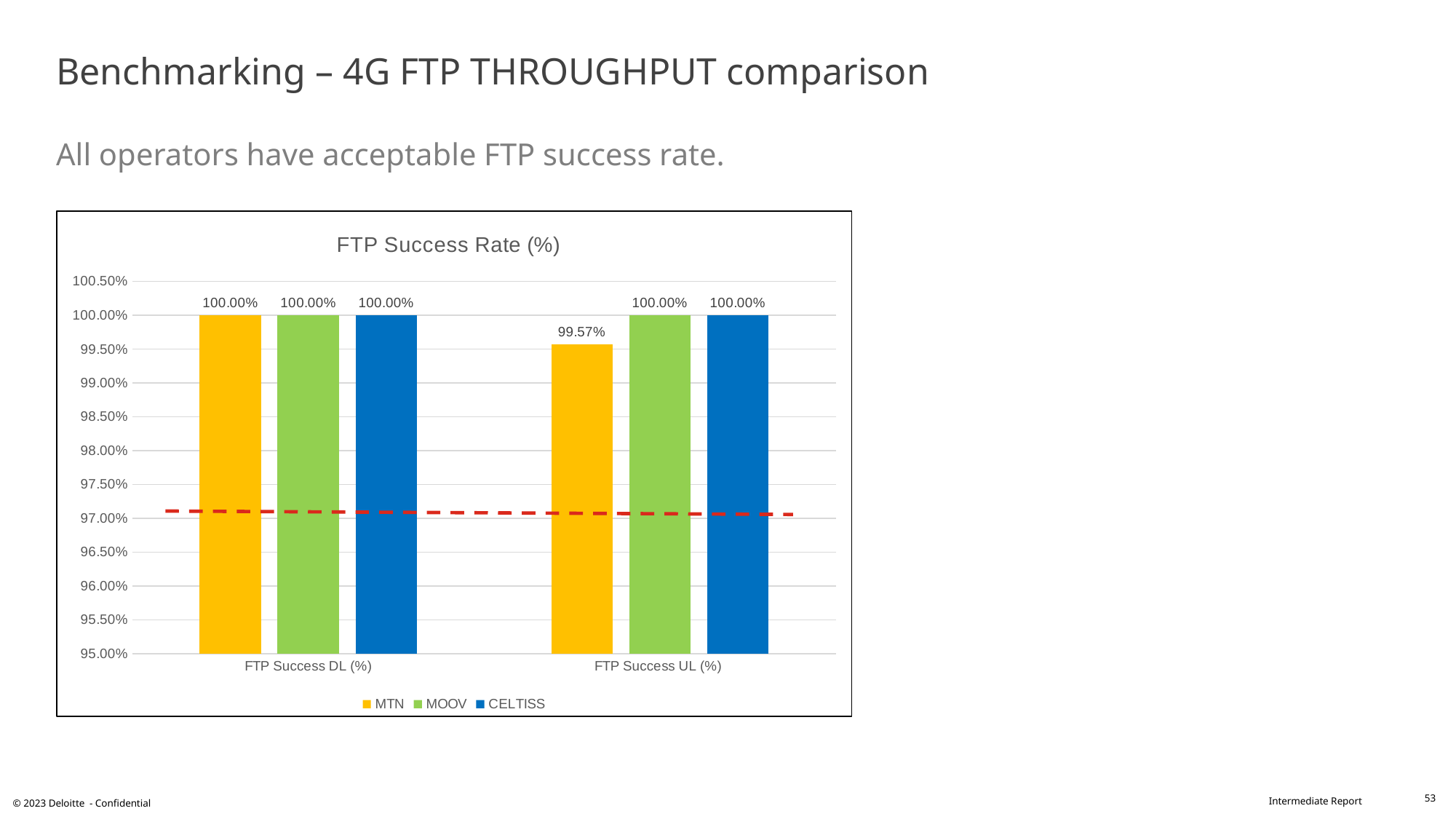
Which operator has the lowest FTP Success UL (%)? MTN What is the FTP Success DL (%) value for CELTISS? 100.00% What kind of chart is shown on the slide? Bar chart Which is larger: MTN's FTP Success DL (%) or MTN's FTP Success UL (%)? FTP Success DL (%) How many categories are shown on the x axis? 2 What is the FTP Success UL (%) value for MOOV? 100.00% Is the value for MTN in FTP Success UL (%) greater or less than 99.00%? greater Which colour represents CELTISS in the chart? Blue What is the difference between MOOV's and MTN's FTP Success UL (%) values? 0.43% How many series does the legend list? 3 What is the FTP Success UL (%) value for MTN? 99.57% What is the title of the chart? FTP Success Rate (%)